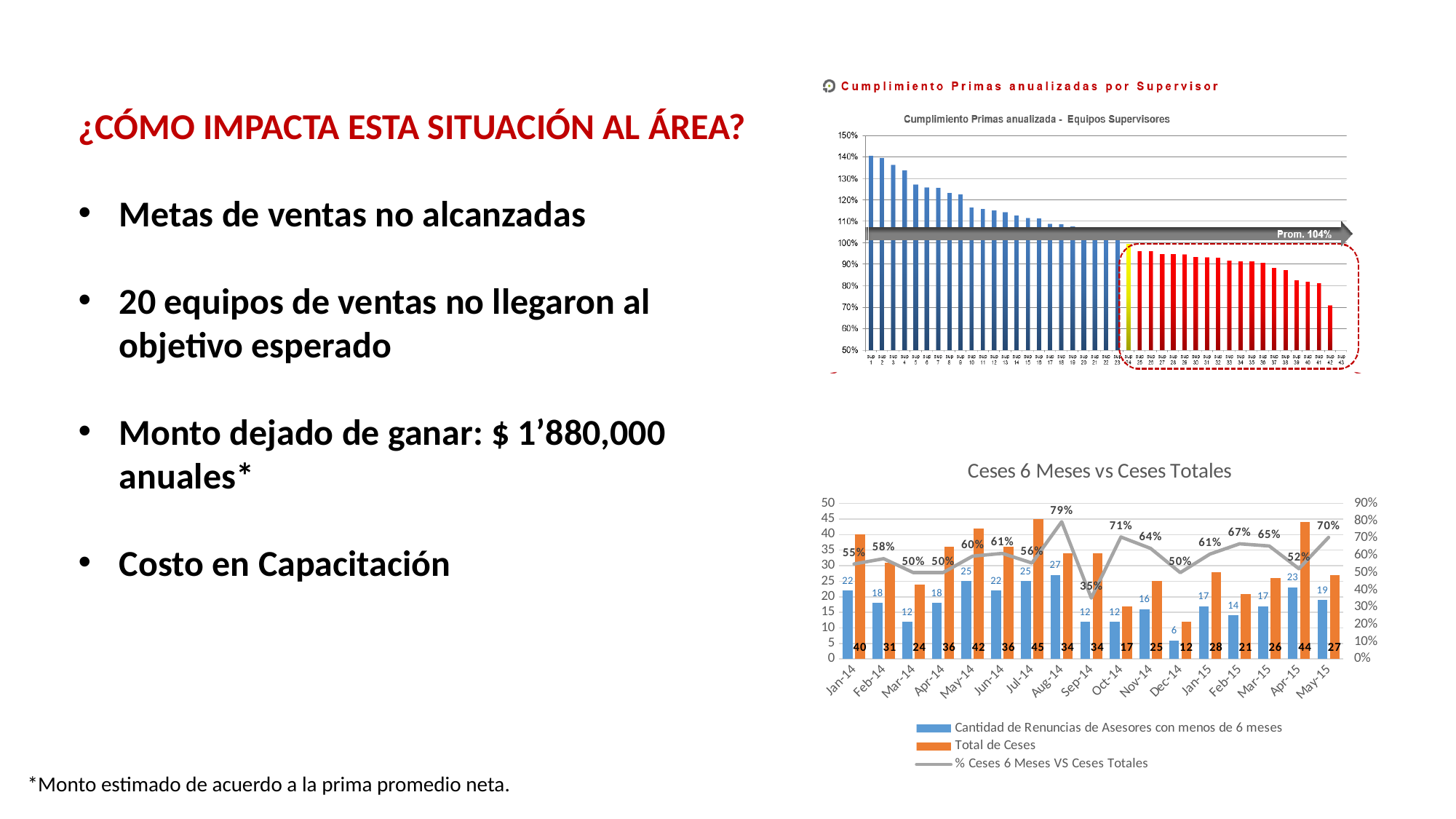
In the 'Ceses 6 Meses vs Ceses Totales' chart, which is larger: Total de Ceses in May-14 or in Jun-14? May-14 What type of chart is the 'Cumplimiento Primas anualizada - Equipos Supervisores' chart? bar chart In the 'Ceses 6 Meses vs Ceses Totales' chart, what is the Total de Ceses value for Jul-14? 45 In the 'Cumplimiento Primas anualizada - Equipos Supervisores' chart, is the value for the first supervisor (sup 1) greater or less than 130%? greater In the 'Ceses 6 Meses vs Ceses Totales' chart, what is the % Ceses 6 Meses VS Ceses Totales for Sep-14? 35% In the 'Ceses 6 Meses vs Ceses Totales' chart, which month has the highest % Ceses 6 Meses VS Ceses Totales? Aug-14 In the 'Ceses 6 Meses vs Ceses Totales' chart, what is the value of Cantidad de Renuncias de Asesores con menos de 6 meses for Aug-14? 27 In the 'Ceses 6 Meses vs Ceses Totales' chart, which month has the lowest Total de Ceses? Dec-14 How many months are shown on the x axis of the 'Ceses 6 Meses vs Ceses Totales' chart? 17 In the 'Ceses 6 Meses vs Ceses Totales' chart, what is the difference between Total de Ceses and Cantidad de Renuncias de Asesores con menos de 6 meses in Apr-15? 21 In the 'Cumplimiento Primas anualizada - Equipos Supervisores' chart, what average value (Prom.) is shown on the arrow? 104% How many series does the legend of the 'Ceses 6 Meses vs Ceses Totales' chart list? 3